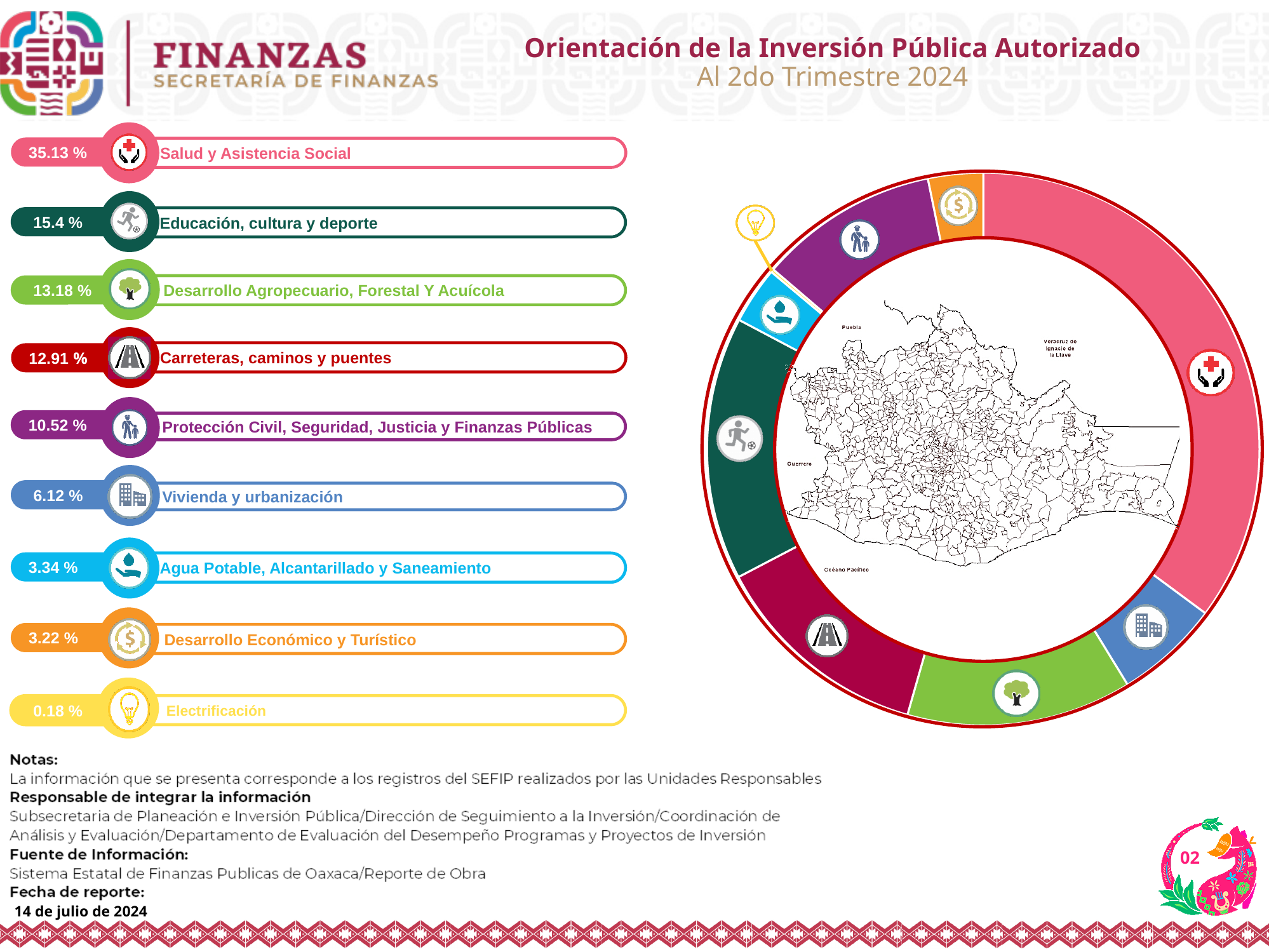
Which has a larger share: Vivienda y urbanización or Desarrollo Económico y Turístico? Vivienda y urbanización What is the title of the slide containing the chart? Orientación de la Inversión Pública Autorizado Al 2do Trimestre 2024 Which category has the smallest share of the authorized public investment? Electrificación What percentage is shown for Salud y Asistencia Social? 35.13 % What percentage is shown for Electrificación? 0.18 % What kind of chart is shown on the slide? Pie (donut) chart What percentage is shown for Agua Potable, Alcantarillado y Saneamiento? 3.34 % What is the difference in percentage points between Salud y Asistencia Social and Educación, cultura y deporte? 19.73 % Which has a larger share: Desarrollo Agropecuario, Forestal Y Acuícola or Carreteras, caminos y puentes? Desarrollo Agropecuario, Forestal Y Acuícola Which category has the largest share of the authorized public investment? Salud y Asistencia Social How many categories are shown in the chart? 9 What percentage is shown for Carreteras, caminos y puentes? 12.91 %